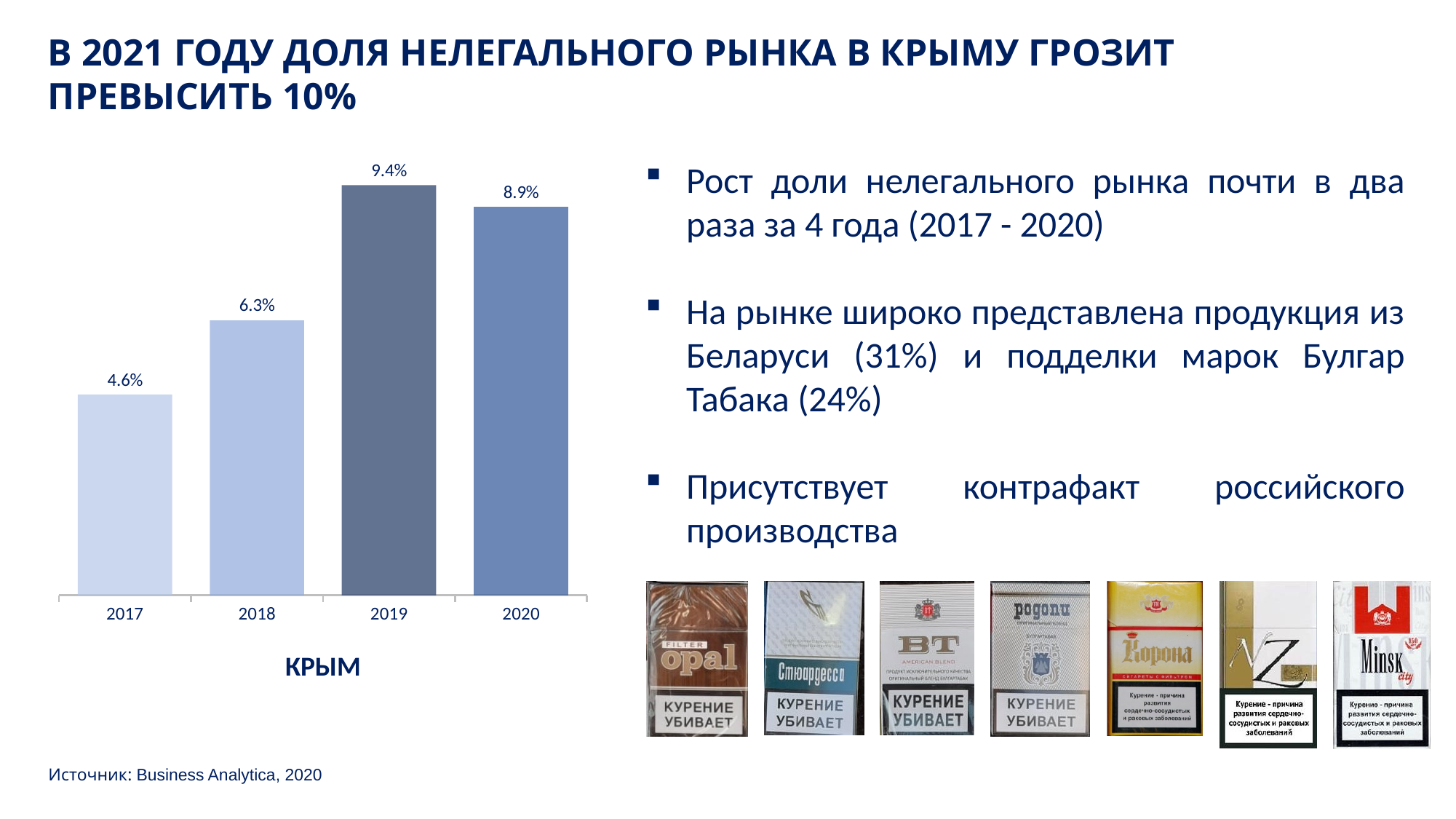
What kind of chart is shown on the slide? bar chart What is the value for 2017 in the chart? 4.6% Which is larger, the value for 2018 or the value for 2020? 2020 What is the difference between the values for 2018 and 2017? 1.7% What is the value for 2020 in the chart? 8.9% Which year has the highest value in the chart? 2019 How many years are shown in the chart? 4 Which year has the lowest value in the chart? 2017 What is the value for 2018 in the chart? 6.3% What is the value for 2019 in the chart? 9.4% What is the label shown below the chart's x axis? КРЫМ What is the difference between the values for 2019 and 2020? 0.5%